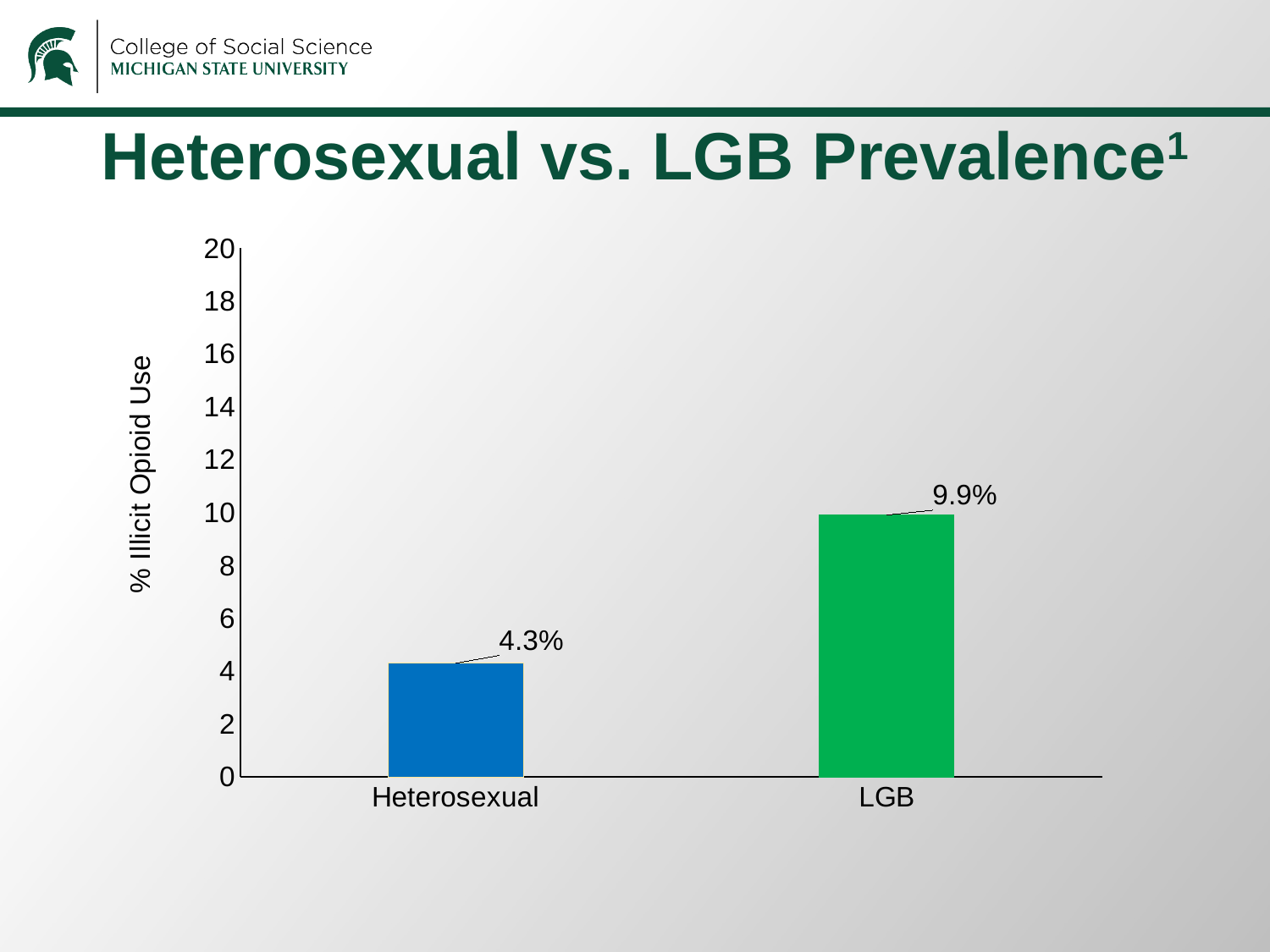
What is the value for Heterosexual? 4.3% Is the value for LGB greater or less than 8? greater How many categories are shown on the x axis? 2 Which is larger, the value for Heterosexual or the value for LGB? LGB Is the value for Heterosexual greater or less than 6? less Which category has the lowest % illicit opioid use? Heterosexual What is the difference between the LGB and Heterosexual values? 5.6% Which category has the highest % illicit opioid use? LGB What kind of chart is shown on the slide? bar chart What is the maximum value shown on the y axis? 20 What is the label of the y axis? % Illicit Opioid Use What is the value for LGB? 9.9%